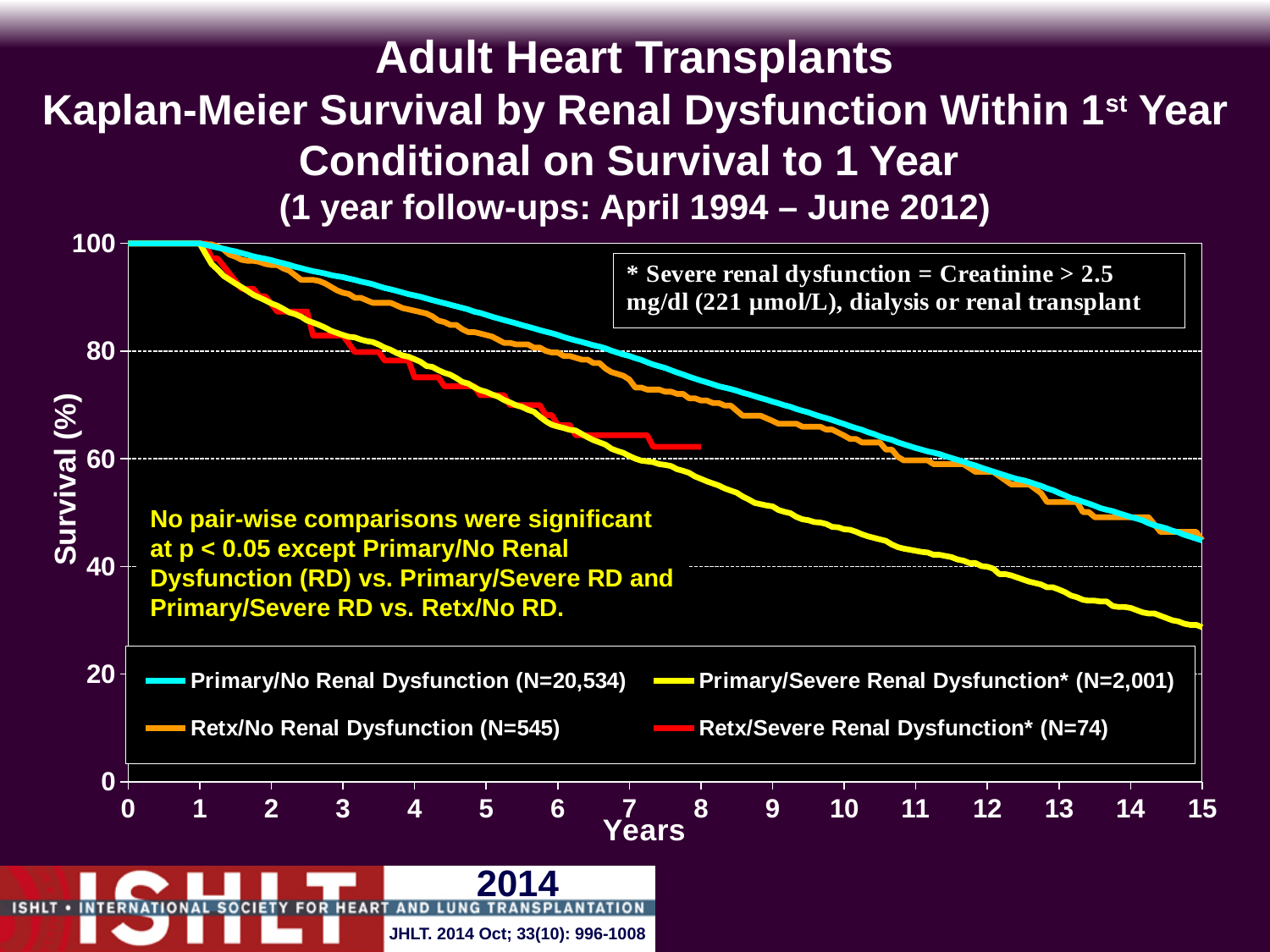
Is the survival for Retx/Severe Renal Dysfunction at 8 years greater or less than 80? less Is the survival for Primary/No Renal Dysfunction at 5 years greater or less than 80? greater Is the survival for Primary/Severe Renal Dysfunction at 15 years greater or less than 40? less Which colour represents the Retx/No Renal Dysfunction series? orange At 15 years, is survival higher for Primary/No Renal Dysfunction or for Primary/Severe Renal Dysfunction? Primary/No Renal Dysfunction Which series has the lowest survival at 15 years? Primary/Severe Renal Dysfunction* (N=2,001) Do the survival curves rise or fall as years increase? fall What is the N for the Primary/No Renal Dysfunction group shown in the legend? 20,534 What kind of chart is shown on the slide? line chart How many series does the legend list? 4